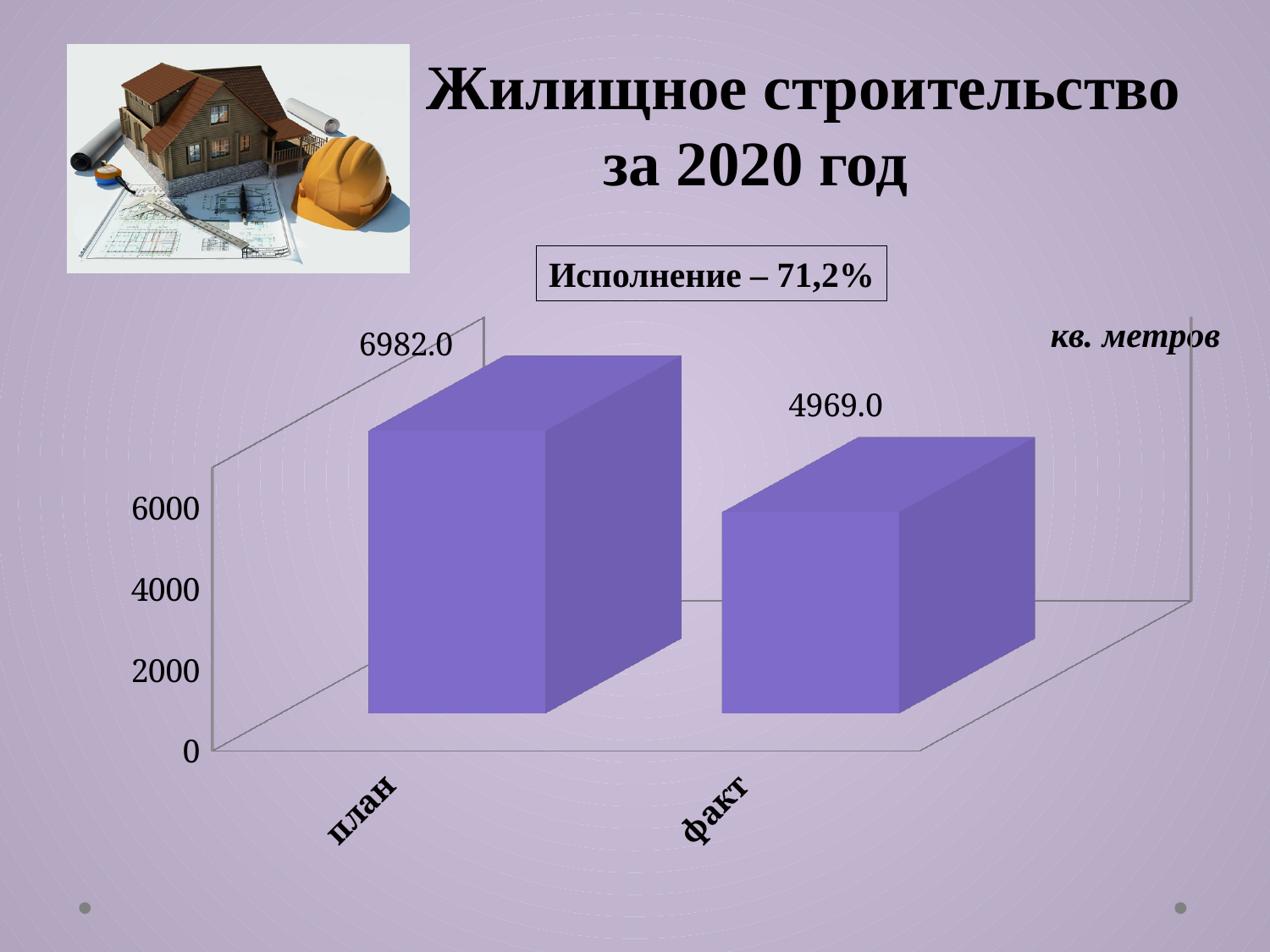
Is the value for факт greater or less than 6000? less Which category has the highest value? план Which category has the lowest value? факт How many categories are shown on the chart? 2 What execution percentage (Исполнение) is stated on the slide? 71,2% What kind of chart is shown on the slide? bar chart What is the difference between the values for план and факт? 2013.0 Is the value for план greater or less than 6000? greater What unit is indicated for the values on the chart? кв. метров What is the value for план? 6982.0 What is the value for факт? 4969.0 Which is larger, the value for план or the value for факт? план